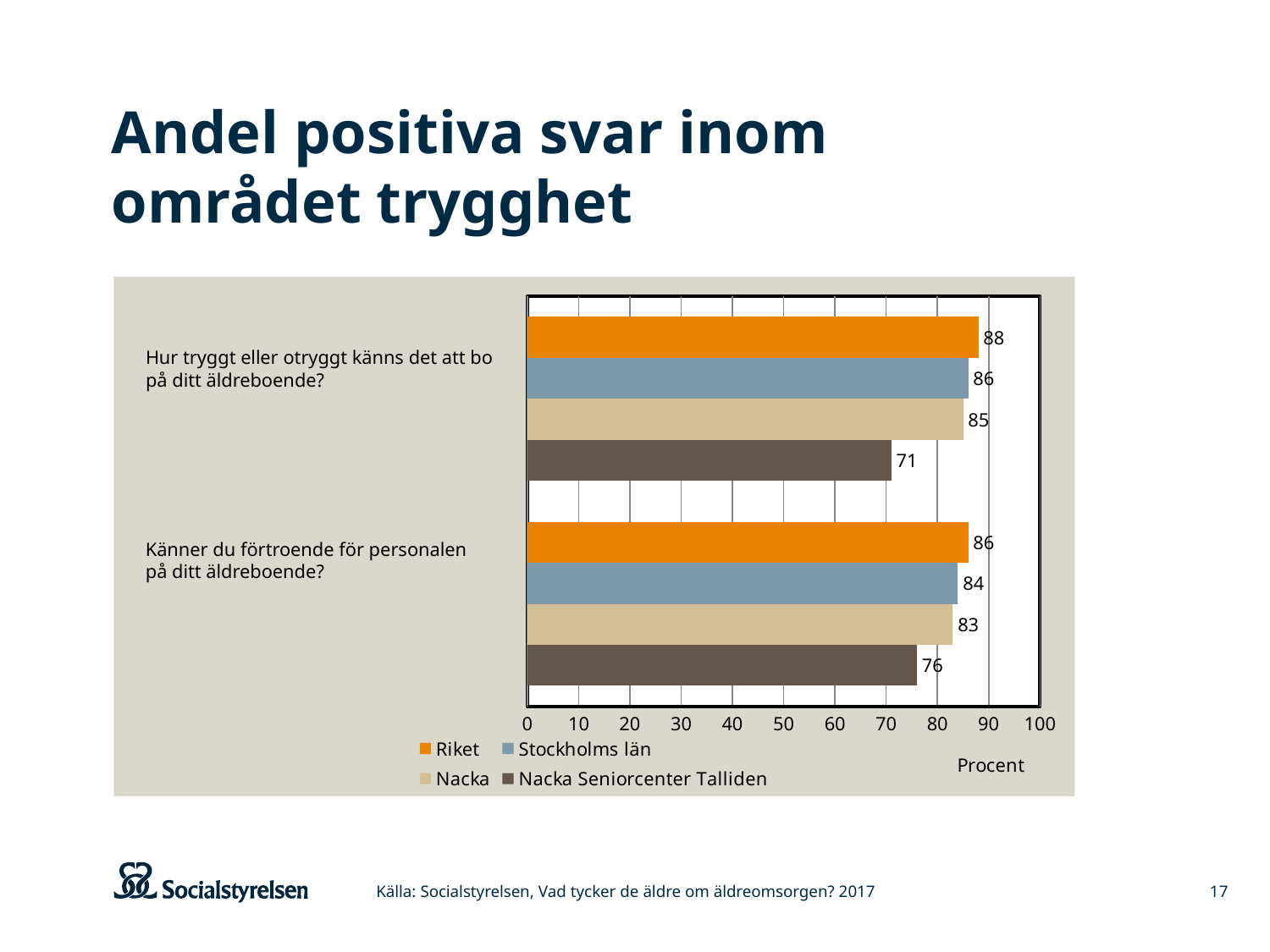
How many questions (categories) are shown on the chart? 2 What is the value for Nacka Seniorcenter Talliden on the question "Känner du förtroende för personalen på ditt äldreboende?"? 76 What unit is shown on the horizontal axis of the chart? Procent What is the value for Stockholms län on the question "Känner du förtroende för personalen på ditt äldreboende?"? 84 Which series has the lowest value on the question "Hur tryggt eller otryggt känns det att bo på ditt äldreboende?"? Nacka Seniorcenter Talliden What is the difference between Nacka and Nacka Seniorcenter Talliden on the question "Känner du förtroende för personalen på ditt äldreboende?"? 7 What kind of chart is shown on the slide? Bar chart What is the difference between Riket and Nacka Seniorcenter Talliden on the question "Hur tryggt eller otryggt känns det att bo på ditt äldreboende?"? 17 Which series has the highest value on the question "Känner du förtroende för personalen på ditt äldreboende?"? Riket Which is larger: the Nacka value for "Hur tryggt eller otryggt känns det att bo på ditt äldreboende?" or the Nacka value for "Känner du förtroende för personalen på ditt äldreboende?"? Hur tryggt eller otryggt känns det att bo på ditt äldreboende? How many series does the legend list? 4 What is the value for Riket on the question "Hur tryggt eller otryggt känns det att bo på ditt äldreboende?"? 88